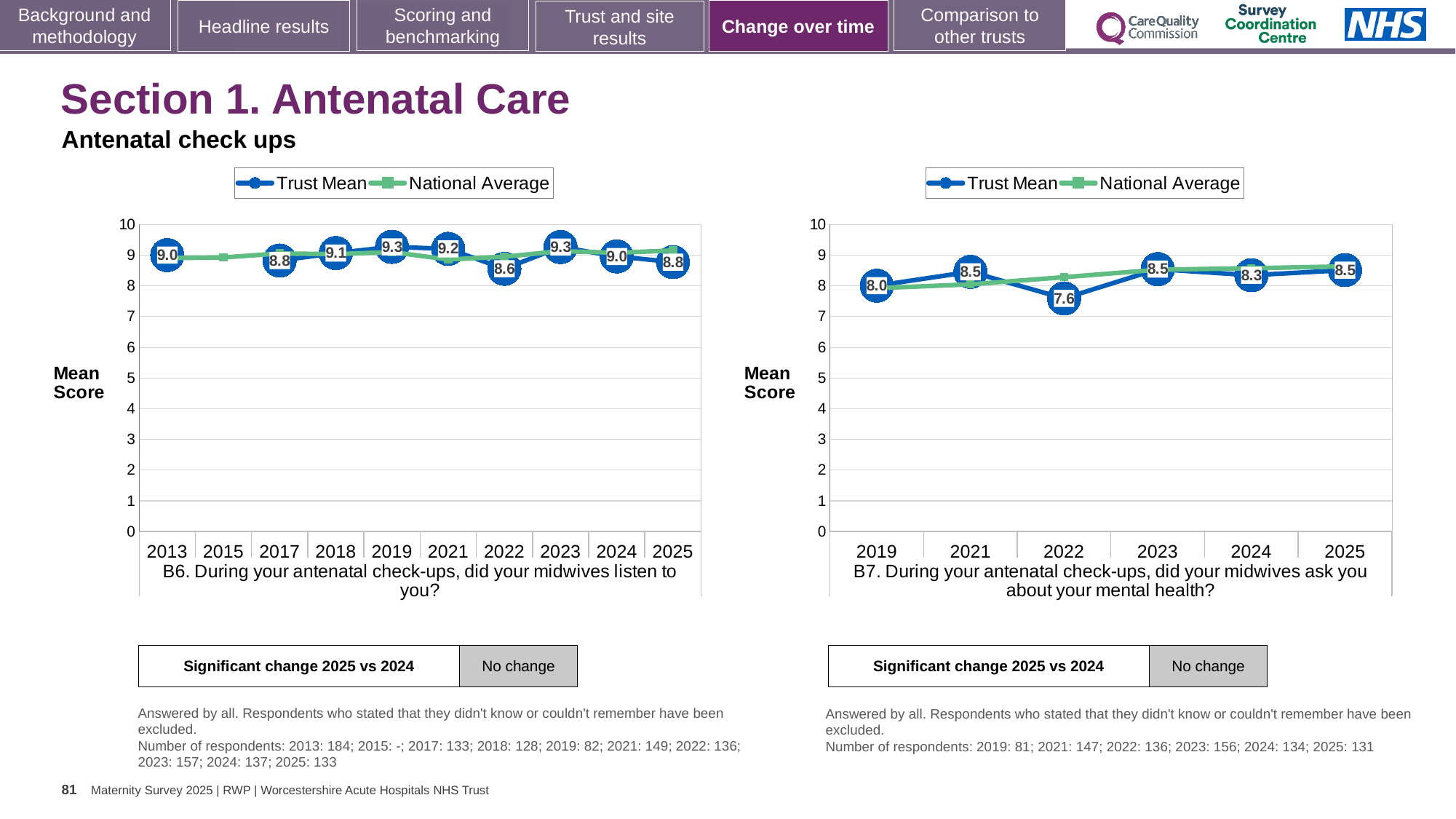
How many series does the legend of the B6 chart on the left list? 2 In the B7 chart on the right, which year has the lowest Trust Mean score? 2022 In the B6 chart on the left, what is the Trust Mean score for 2019? 9.3 What kind of chart is the B7 chart on the right? Line chart In the B7 chart on the right, what is the Trust Mean score for 2022? 7.6 How many years are shown on the x axis of the B7 chart on the right? 6 In the B6 chart on the left, which year has the lowest Trust Mean score? 2022 In the B6 chart on the left, what is the Trust Mean score for 2025? 8.8 In the B7 chart on the right, what is the difference between the Trust Mean scores for 2021 and 2022? 0.9 In the B7 chart on the right, what is the Trust Mean score for 2019? 8.0 In the B6 chart on the left, what is the difference between the Trust Mean scores for 2019 and 2022? 0.7 In the B6 chart on the left, which year has the higher Trust Mean score, 2018 or 2022? 2018